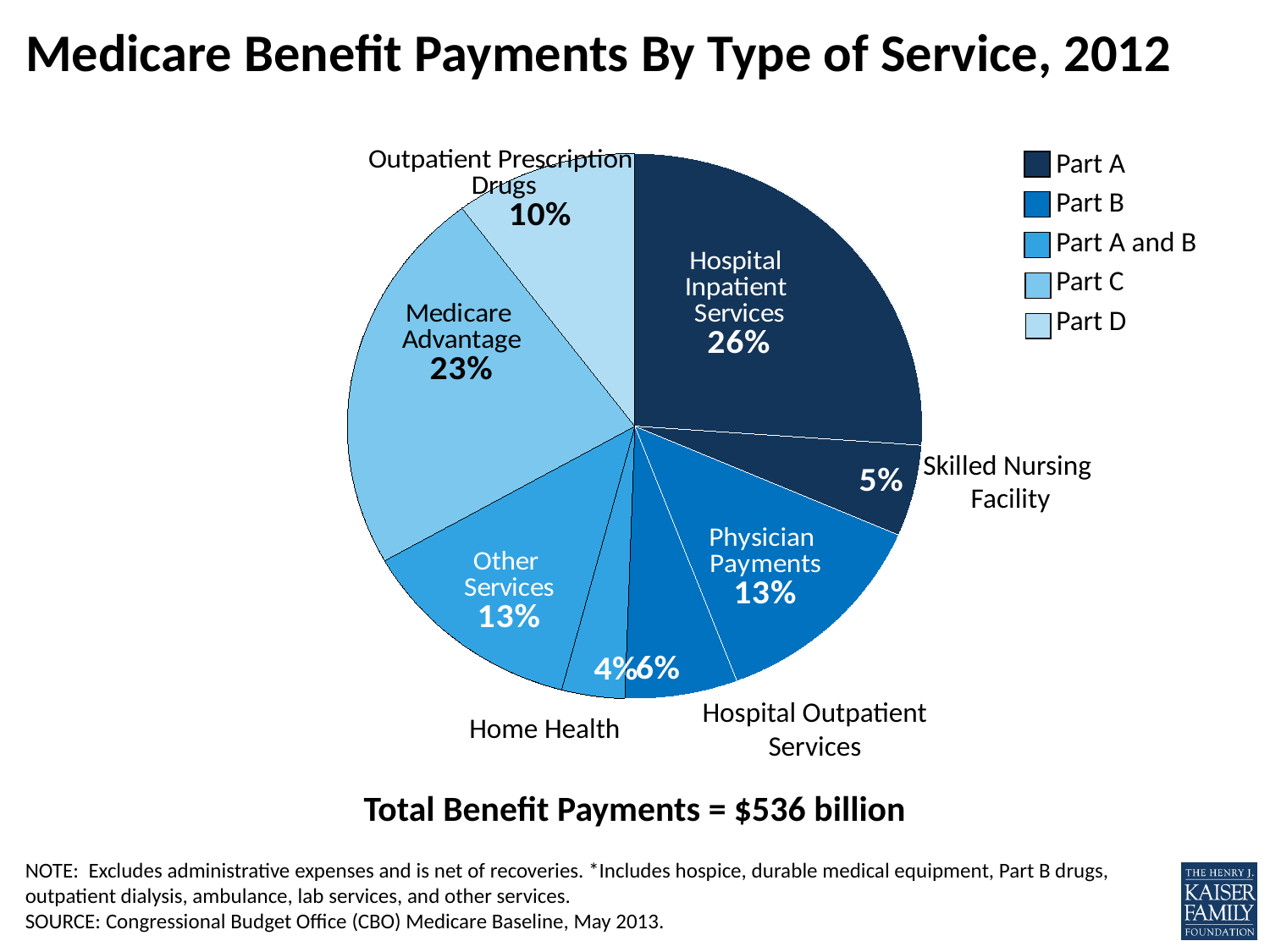
What share of Medicare benefit payments went to Medicare Advantage? 23% What share of Medicare benefit payments went to Skilled Nursing Facility? 5% Which has a larger share: Physician Payments or Hospital Outpatient Services? Physician Payments What kind of chart is shown on the slide? Pie chart How many entries does the legend list? 5 How many slices does the pie chart have? 8 Which type of service has the smallest share of Medicare benefit payments? Home Health What share of Medicare benefit payments went to Hospital Inpatient Services? 26% What is the total benefit payments amount stated below the chart? $536 billion How many percentage points larger is the Hospital Inpatient Services share than the Medicare Advantage share? 3 percentage points What share of Medicare benefit payments went to Outpatient Prescription Drugs? 10% Which type of service has the largest share of Medicare benefit payments? Hospital Inpatient Services